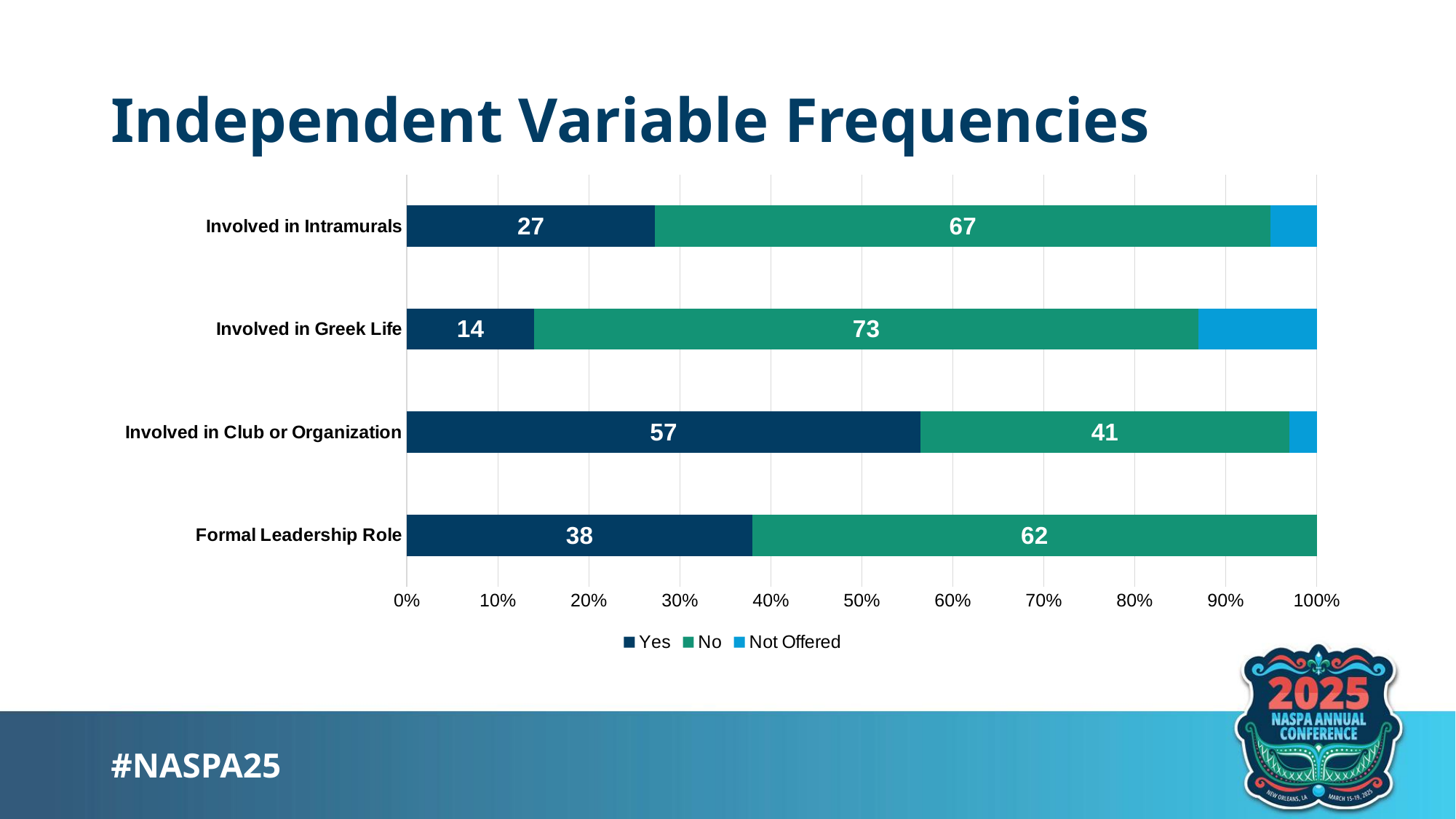
How many series does the legend list? 3 What is the value of the Yes segment for Involved in Club or Organization? 57 How many categories are shown on the chart? 4 What type of chart is shown on the slide? Stacked bar chart Which is larger: the Yes value for Formal Leadership Role or the Yes value for Involved in Intramurals? Formal Leadership Role Which category has the lowest Yes value? Involved in Greek Life What is the difference between the Yes and No values for Involved in Club or Organization? 16 What is the value of the No segment for Formal Leadership Role? 62 What is the value of the No segment for Involved in Greek Life? 73 What is the value of the Yes segment for Involved in Intramurals? 27 Which category has the highest Yes value? Involved in Club or Organization Is the Not Offered segment for Involved in Intramurals greater or less than 10%? less